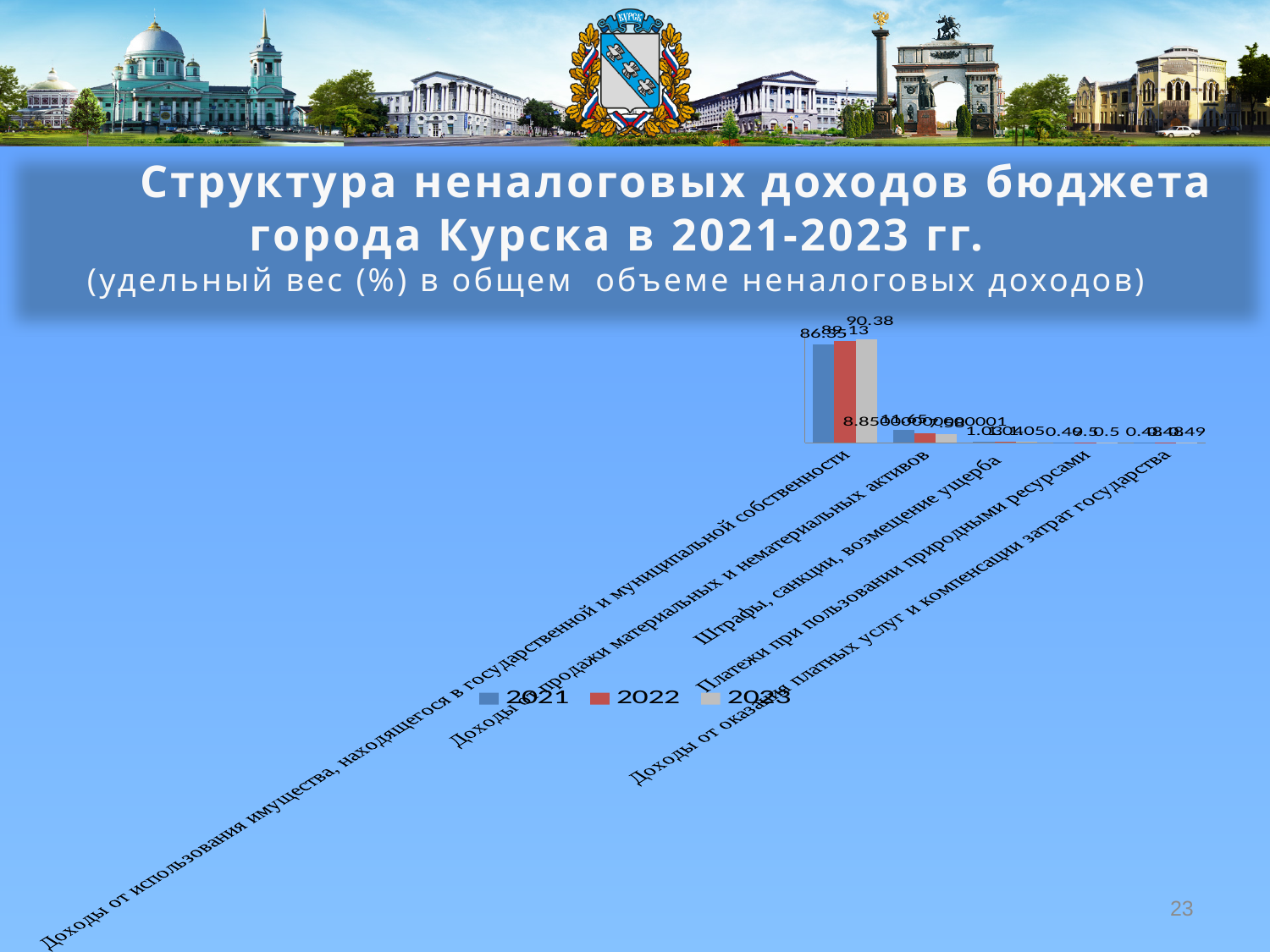
For 'Доходы от использования имущества, находящегося в государственной и муниципальной собственности', do the values rise or fall from 2021 to 2023? rise How many categories are plotted on the x axis? 5 For 'Доходы от использования имущества, находящегося в государственной и муниципальной собственности', which is larger: the 2021 value or the 2023 value? 2023 Which category has the highest values across all three years? Доходы от использования имущества, находящегося в государственной и муниципальной собственности What is the difference between the 2023 and 2021 values for 'Доходы от использования имущества, находящегося в государственной и муниципальной собственности'? 4.03 What is the 2022 value for 'Доходы от использования имущества, находящегося в государственной и муниципальной собственности'? 89.13 What is the 2021 value for 'Доходы от использования имущества, находящегося в государственной и муниципальной собственности'? 86.35 Which years are listed in the legend? 2021, 2022, 2023 What kind of chart is shown on the slide? bar chart What is the 2023 value for 'Доходы от использования имущества, находящегося в государственной и муниципальной собственности'? 90.38 How many series does the legend list? 3 What is the 2021 value for 'Доходы от продажи материальных и нематериальных активов'? 11.65